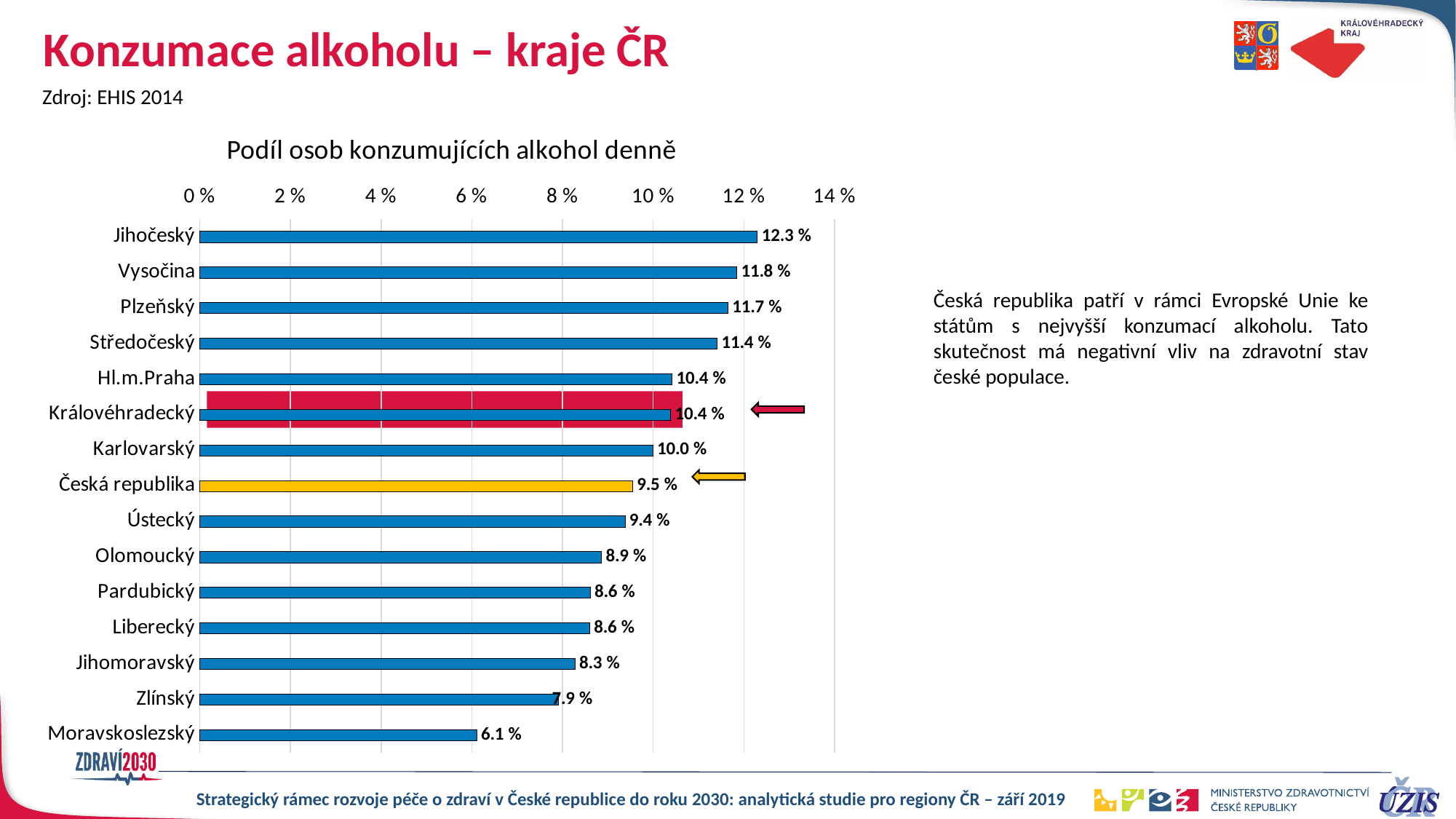
What is the value for Jihočeský? 12.3 % What is the difference between the values for Jihočeský and Moravskoslezský? 6.2 % Which category has the highest value? Jihočeský What is the value for Česká republika? 9.5 % What is the value for Královéhradecký? 10.4 % Which has a larger value, Plzeňský or Karlovarský? Plzeňský What is the value for Moravskoslezský? 6.1 % What kind of chart is shown on the slide? bar chart How many categories are shown in the chart? 15 Is the value for Zlínský greater or less than 8 %? less What is the difference between the values for Vysočina and Česká republika? 2.3 % Which category has the lowest value? Moravskoslezský